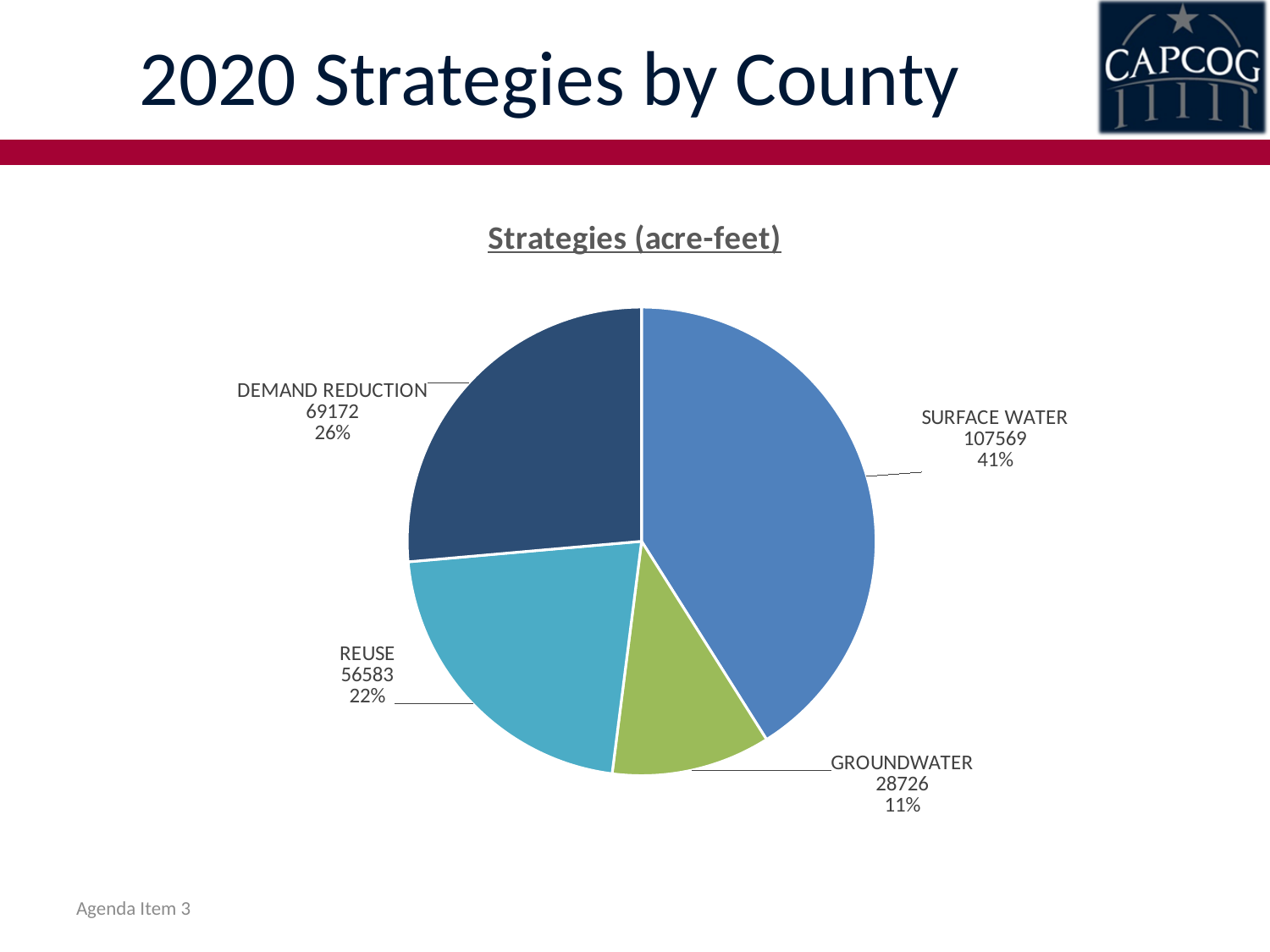
What is the value for SURFACE WATER? 107569 What share of the pie does DEMAND REDUCTION represent? 26% What is the value for GROUNDWATER? 28726 Which is larger, DEMAND REDUCTION or REUSE? DEMAND REDUCTION What share of the pie does REUSE represent? 22% Which category has the smallest slice? GROUNDWATER What is the value for REUSE? 56583 What type of chart is shown on the slide? pie chart How many categories are shown in the pie chart? 4 What is the difference between the SURFACE WATER and GROUNDWATER values? 78843 Which category has the largest slice? SURFACE WATER What is the value for DEMAND REDUCTION? 69172